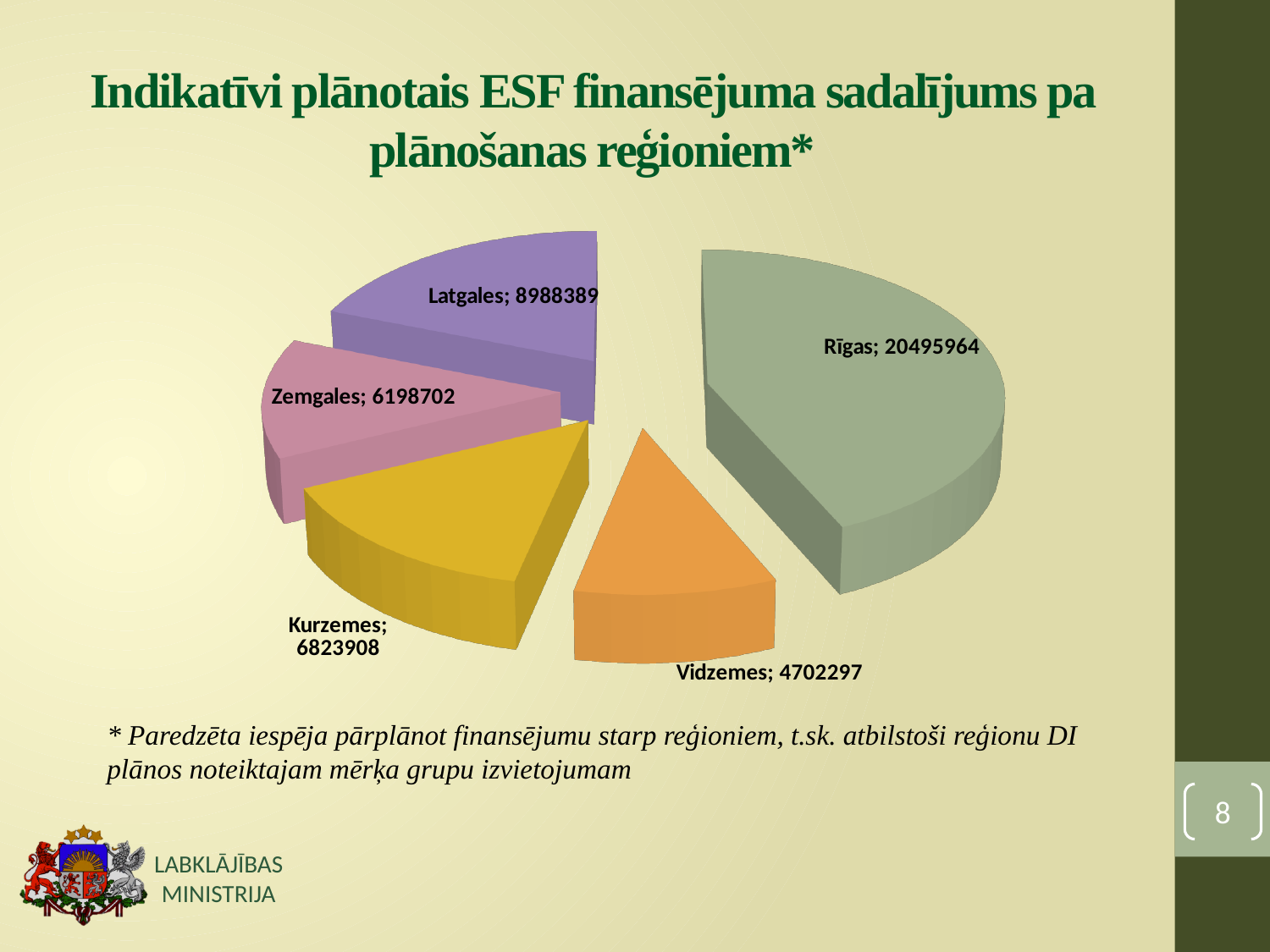
What is the value for Vidzemes in the pie chart? 4702297 Which region has the largest slice in the pie chart? Rīgas Which is larger, the value for Kurzemes or the value for Zemgales? Kurzemes How many regions (slices) are shown in the pie chart? 5 What is the difference between the values for Rīgas and Latgales? 11507575 What is the value for Rīgas in the pie chart? 20495964 What is the total of all the slice values in the pie chart? 47209260 What is the value for Latgales in the pie chart? 8988389 What is the difference between the values for Kurzemes and Zemgales? 625206 Which region has the smallest slice in the pie chart? Vidzemes What kind of chart is shown on the slide? Pie chart What is the value for Kurzemes in the pie chart? 6823908